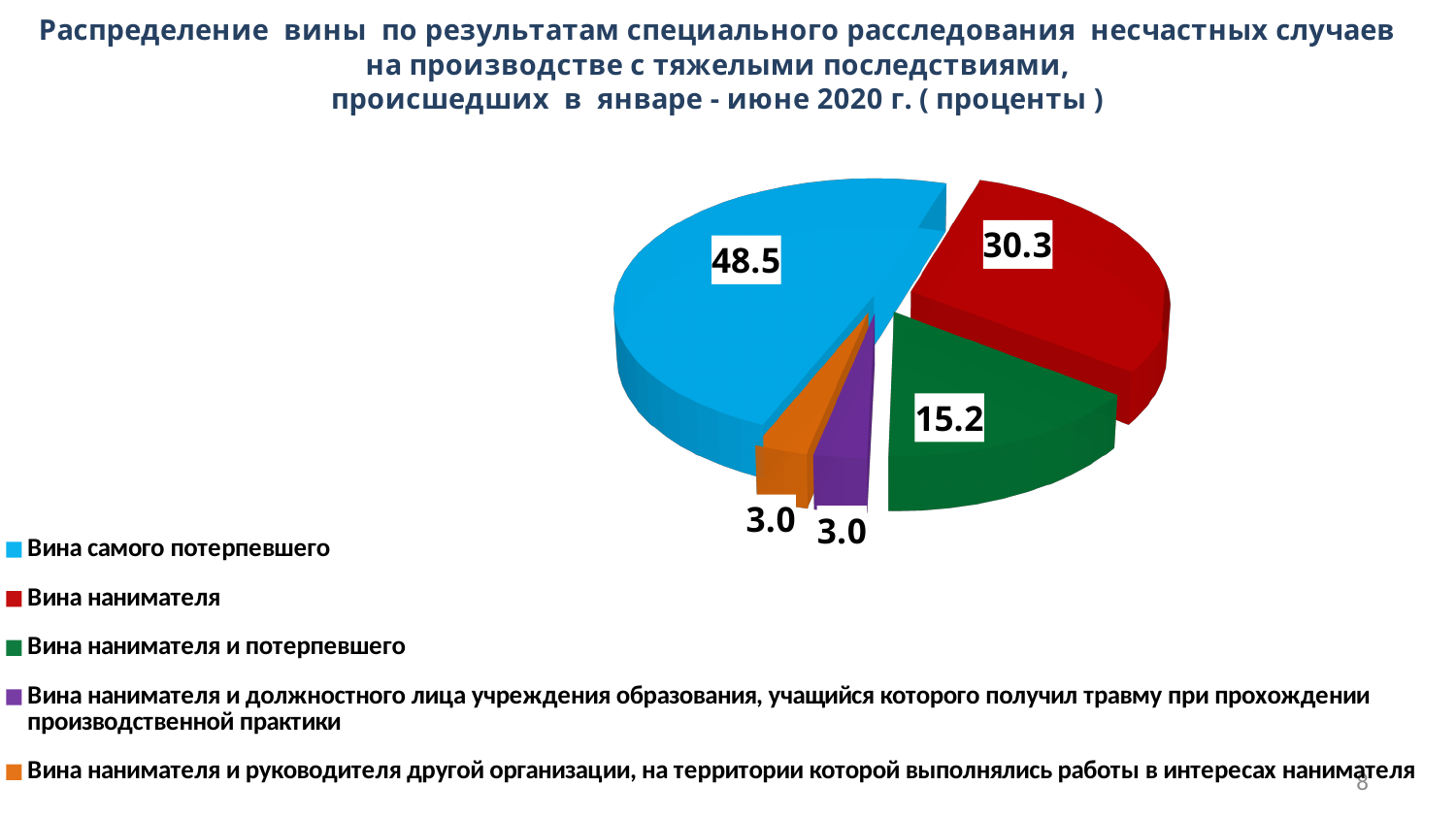
What is the value for "Вина нанимателя"? 30.3 What is the value for "Вина самого потерпевшего"? 48.5 How many slices does the pie chart have? 5 What type of chart is shown on the slide? Pie chart What colour is the slice for "Вина нанимателя и потерпевшего"? Green What is the value for "Вина нанимателя и потерпевшего"? 15.2 Which category has the largest share of the pie? Вина самого потерпевшего What is the value for "Вина нанимателя и руководителя другой организации, на территории которой выполнялись работы в интересах нанимателя"? 3.0 Which is larger: the value for "Вина нанимателя" or the value for "Вина нанимателя и потерпевшего"? Вина нанимателя What is the difference between the values for "Вина самого потерпевшего" and "Вина нанимателя"? 18.2 How many entries does the legend list? 5 What is the smallest value shown on the pie chart? 3.0